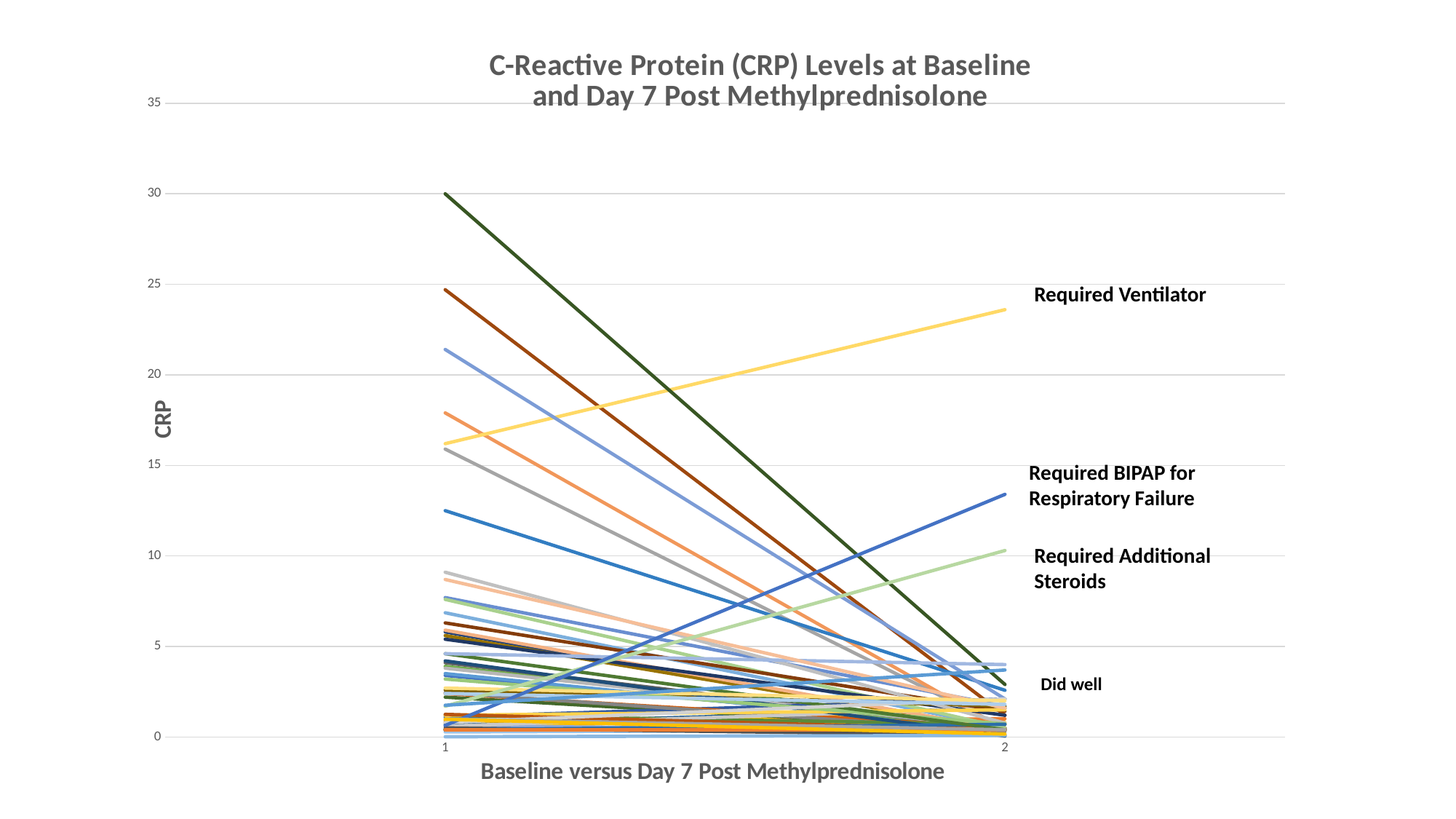
Is the value of the "Required Ventilator" line at point 2 greater or less than 20? greater What kind of chart is shown on the slide? line chart At point 2, which line has the larger value: "Required Ventilator" or "Required BIPAP for Respiratory Failure"? Required Ventilator What is the title of the chart? C-Reactive Protein (CRP) Levels at Baseline and Day 7 Post Methylprednisolone Is the value of the "Required Additional Steroids" line at point 2 greater or less than 15? less Is the value of the "Required Ventilator" line at point 1 greater or less than 10? greater What is the label on the x axis of the chart? Baseline versus Day 7 Post Methylprednisolone Does the line labelled "Required Ventilator" rise or fall from point 1 to point 2? rise Does the line labelled "Required BIPAP for Respiratory Failure" rise or fall from point 1 to point 2? rise How many points are there along the x axis of the chart? 2